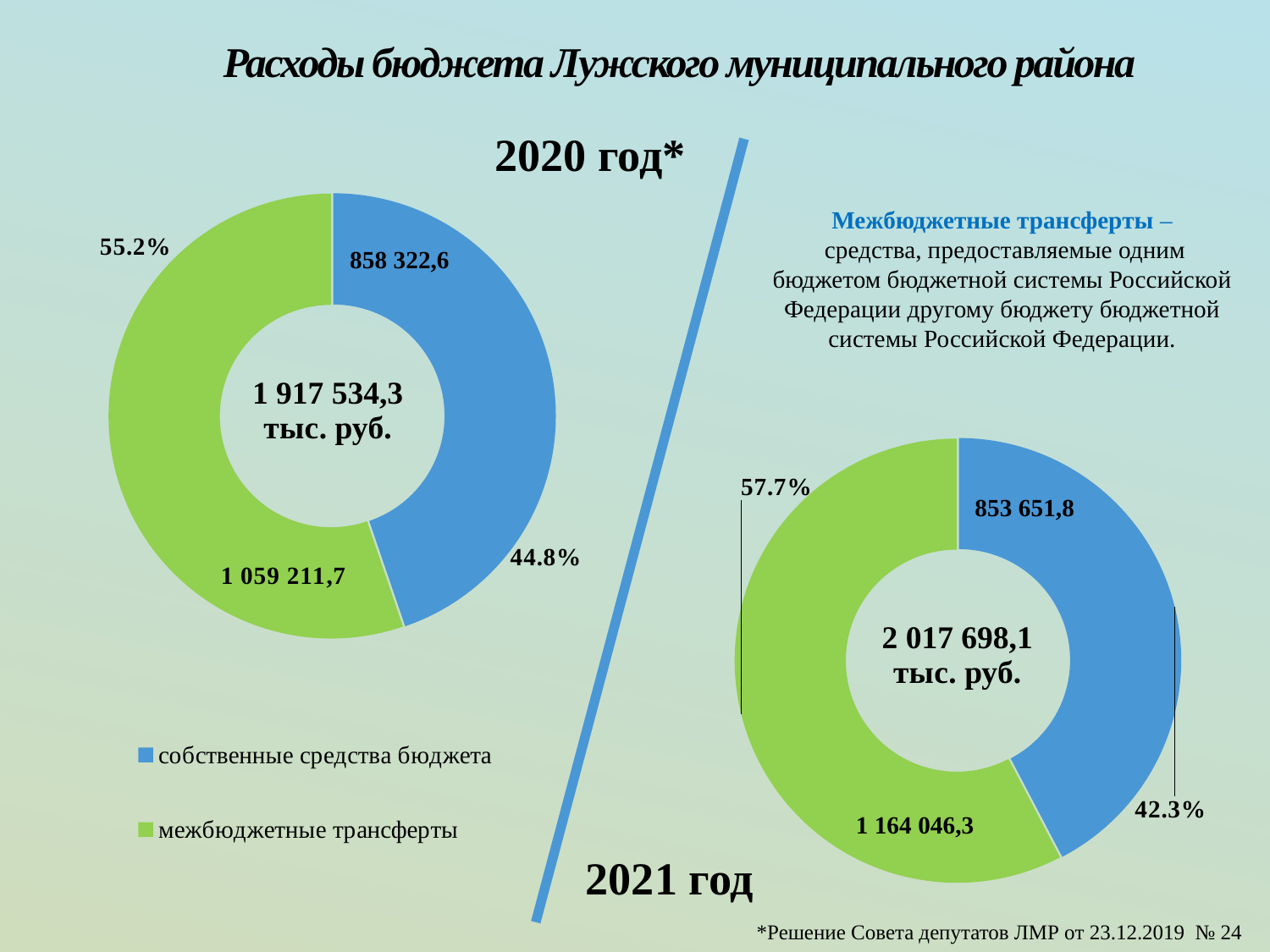
In the 2021 год chart, which category is the smallest? собственные средства бюджета In the 2021 год chart, what share of the total do межбюджетные трансферты make up? 57.7% What is the total shown in the centre of the 2021 год chart? 2 017 698,1 тыс. руб. How many categories does the legend list? 2 In the 2021 год chart, what is the value for межбюджетные трансферты? 1 164 046,3 In the 2020 год chart, what is the value for собственные средства бюджета? 858 322,6 What kind of chart is used for the 2020 год data? Doughnut chart In the 2020 год chart, what is the value for межбюджетные трансферты? 1 059 211,7 Which is larger: межбюджетные трансферты in 2020 год or in 2021 год? 2021 год In the 2020 год chart, which category is the largest? межбюджетные трансферты In the 2021 год chart, what is the value for собственные средства бюджета? 853 651,8 In the 2020 год chart, what share of the total do собственные средства бюджета make up? 44.8%